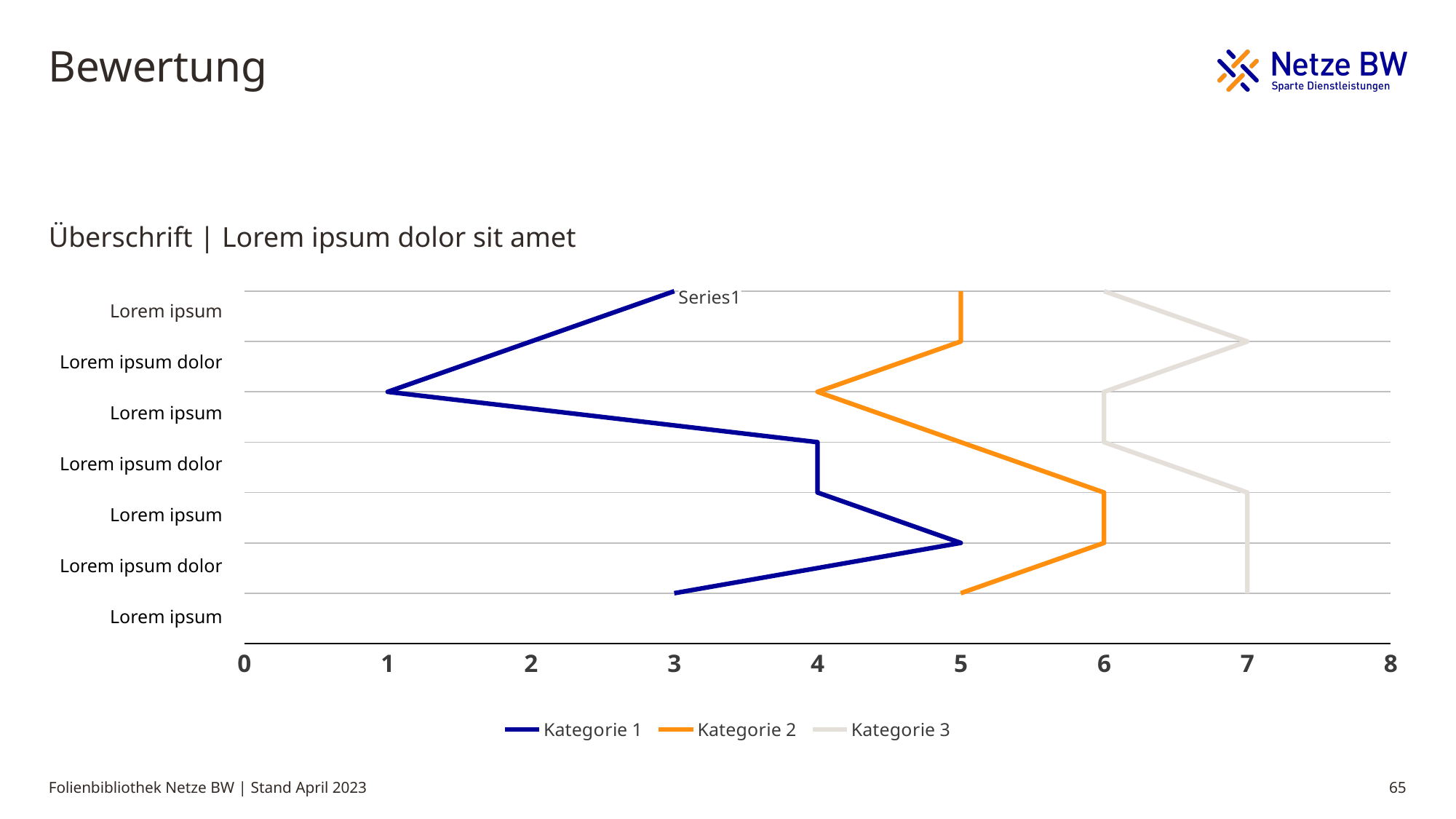
Is the value of Kategorie 3 for the topmost category greater or less than 5? greater What is the value of Kategorie 2 for the topmost category? 5 What is the value of Kategorie 3 for the bottom category? 7 What kind of chart is shown on the slide? Line chart What is the lowest value reached by the Kategorie 1 line? 1 For the bottom category, what is the difference between the Kategorie 3 value and the Kategorie 1 value? 4 What is the highest value reached by the Kategorie 1 line? 5 For the bottom category, which series has the larger value, Kategorie 1 or Kategorie 3? Kategorie 3 How many series does the legend list? 3 What is the highest value shown on the horizontal axis? 8 What is the value of Kategorie 1 for the topmost category? 3 How many categories are listed on the vertical axis of the chart? 7